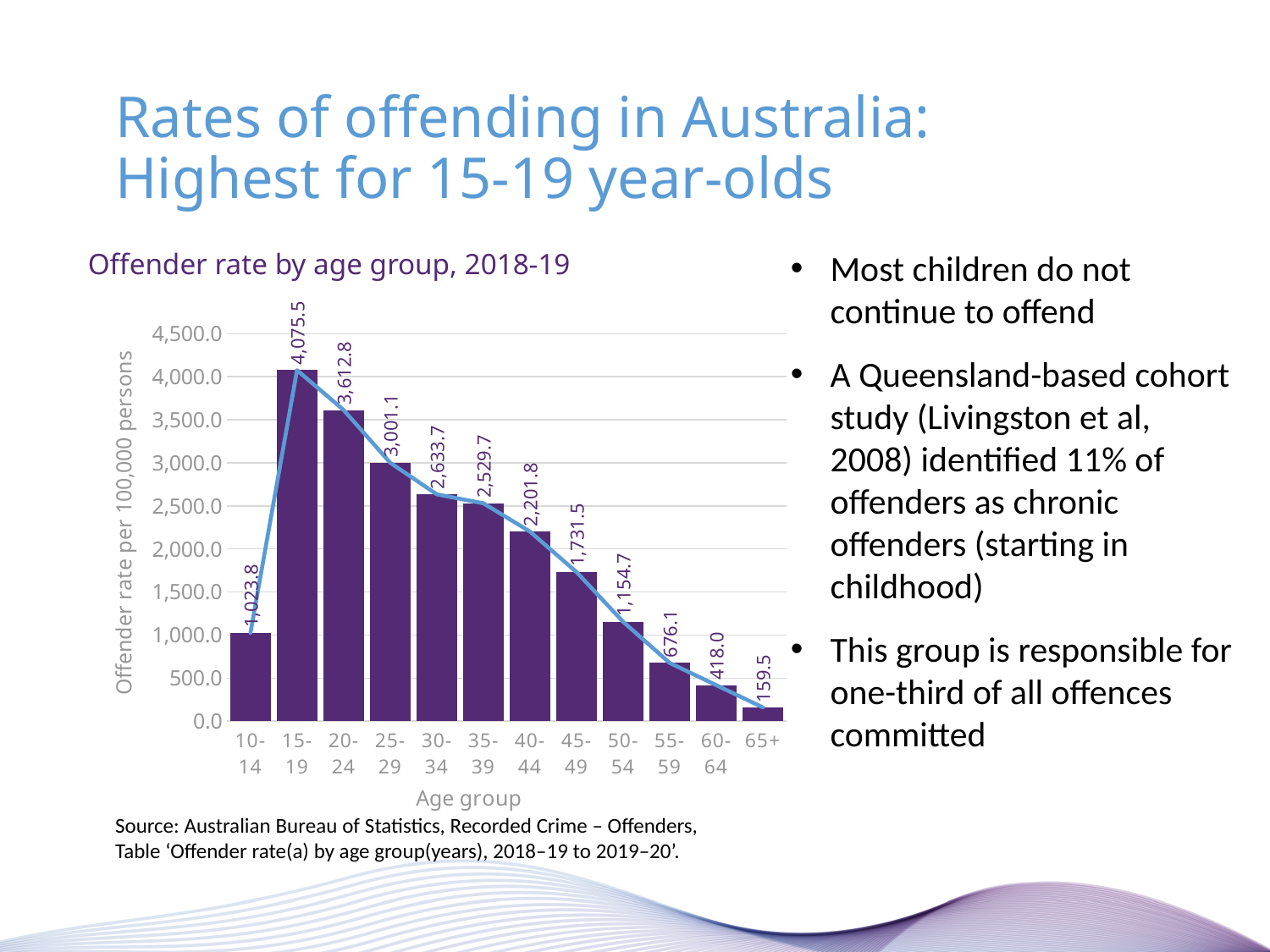
What is the offender rate for the 10-14 age group? 1,023.8 What is the difference between the offender rates for the 15-19 and 20-24 age groups? 462.7 How many age groups are shown on the chart? 12 What is the offender rate for the 15-19 age group? 4,075.5 Which age group has the highest offender rate? 15-19 Which age group has the lowest offender rate? 65+ What is the title of the chart? Offender rate by age group, 2018-19 Which age group has a higher offender rate, 30-34 or 40-44? 30-34 How does the offender rate change from the 15-19 age group to the 65+ age group? It falls What is the offender rate for the 65+ age group? 159.5 Is the offender rate for the 50-54 age group greater or less than 1,000.0? greater What kind of chart is used to show the offender rate by age group? Bar chart (with a line overlay)